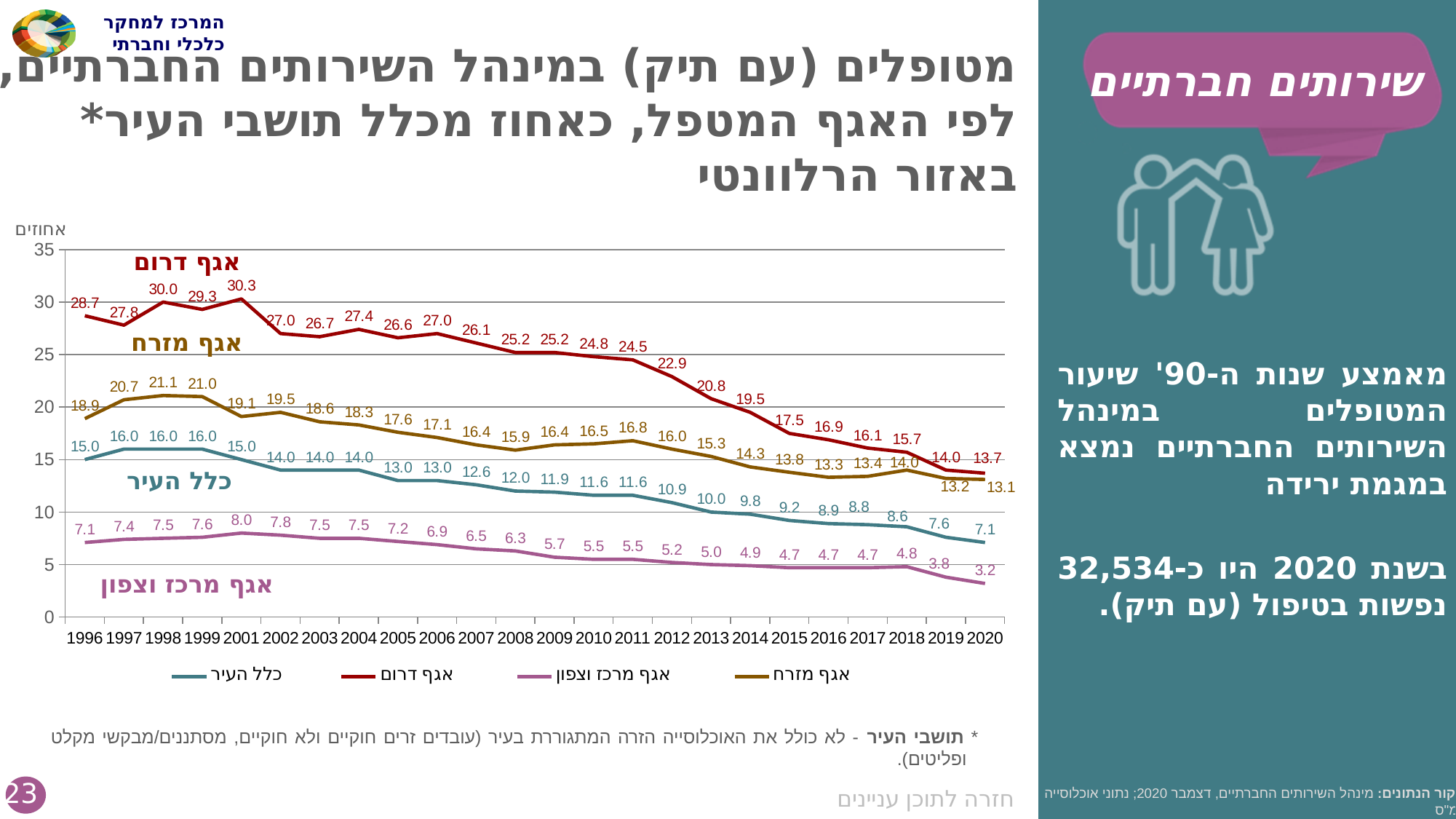
What is the value for כלל העיר in 1996? 15.0 In which year does אגף מרכז וצפון have its lowest value? 2020 Which is larger in 2018: the value for אגף מזרח or the value for כלל העיר? אגף מזרח How many years are shown on the x axis? 24 In which year does אגף דרום reach its highest value? 2001 What is the difference between the אגף דרום value in 1996 and in 2020? 15.0 What is the value for אגף דרום in 2020? 13.7 How many series does the legend list? 4 Does the value for כלל העיר rise or fall from 2001 to 2020? fall What is the value for אגף מזרח in 2011? 16.8 What is the value for אגף מרכז וצפון in 2001? 8.0 What type of chart is shown on the slide? line chart